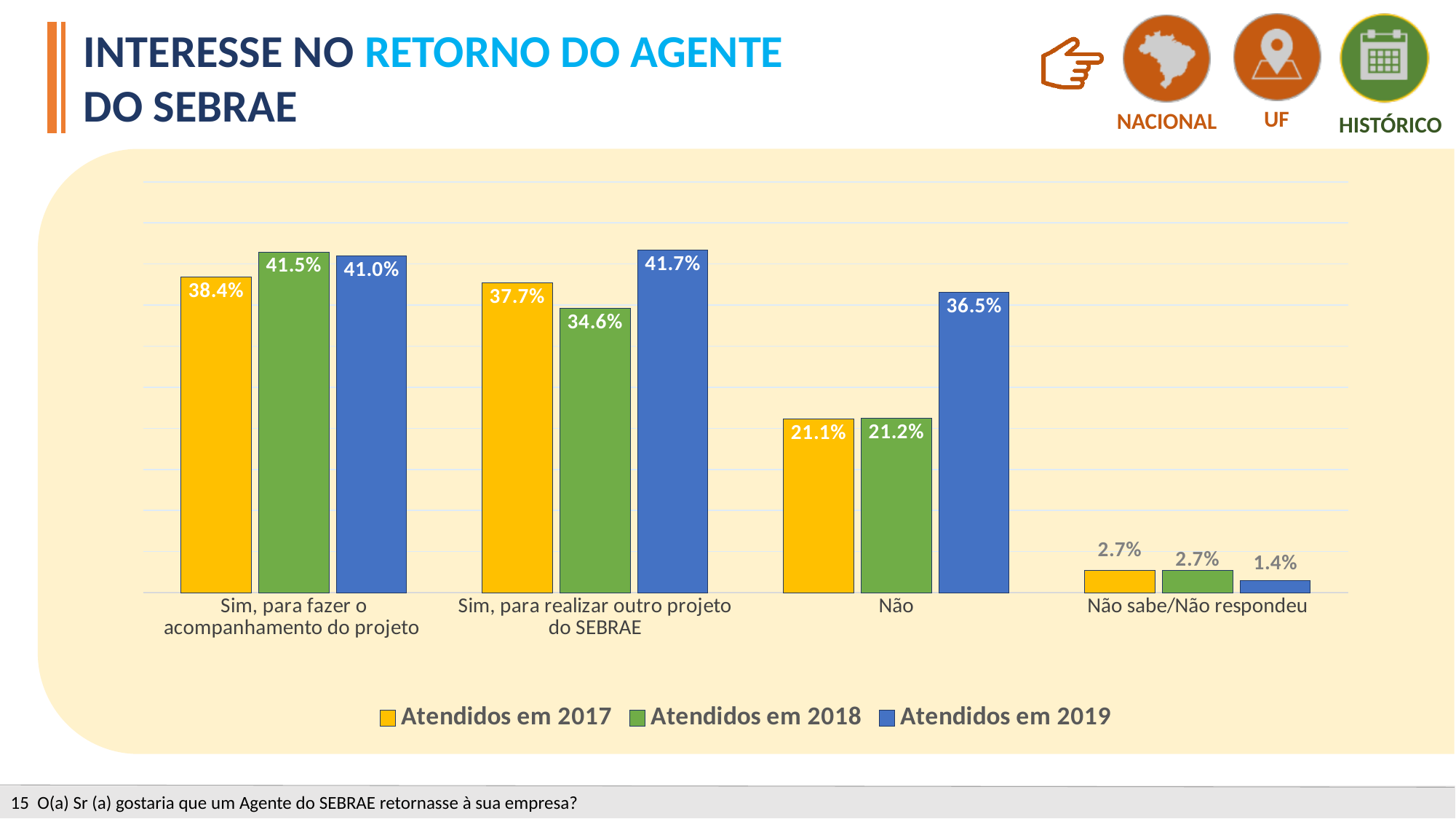
How many series does the legend list? 3 What is the value for "Atendidos em 2017" in the "Sim, para fazer o acompanhamento do projeto" category? 38.4% What is the value for "Atendidos em 2018" in the "Sim, para realizar outro projeto do SEBRAE" category? 34.6% Which colour represents "Atendidos em 2018" in the legend? Green What is the difference between the "Atendidos em 2019" and "Atendidos em 2017" values in the "Não" category? 15.4% How many categories are shown on the x axis? 4 What is the value for "Atendidos em 2019" in the "Não" category? 36.5% What kind of chart is shown on the slide? Bar chart Which category has the highest value for "Atendidos em 2018"? Sim, para fazer o acompanhamento do projeto In the "Sim, para realizar outro projeto do SEBRAE" category, which series has the larger value: "Atendidos em 2017" or "Atendidos em 2019"? Atendidos em 2019 Which category has the lowest value for "Atendidos em 2019"? Não sabe/Não respondeu How does the value for "Atendidos em 2019" change from "Sim, para realizar outro projeto do SEBRAE" to "Não"? It falls